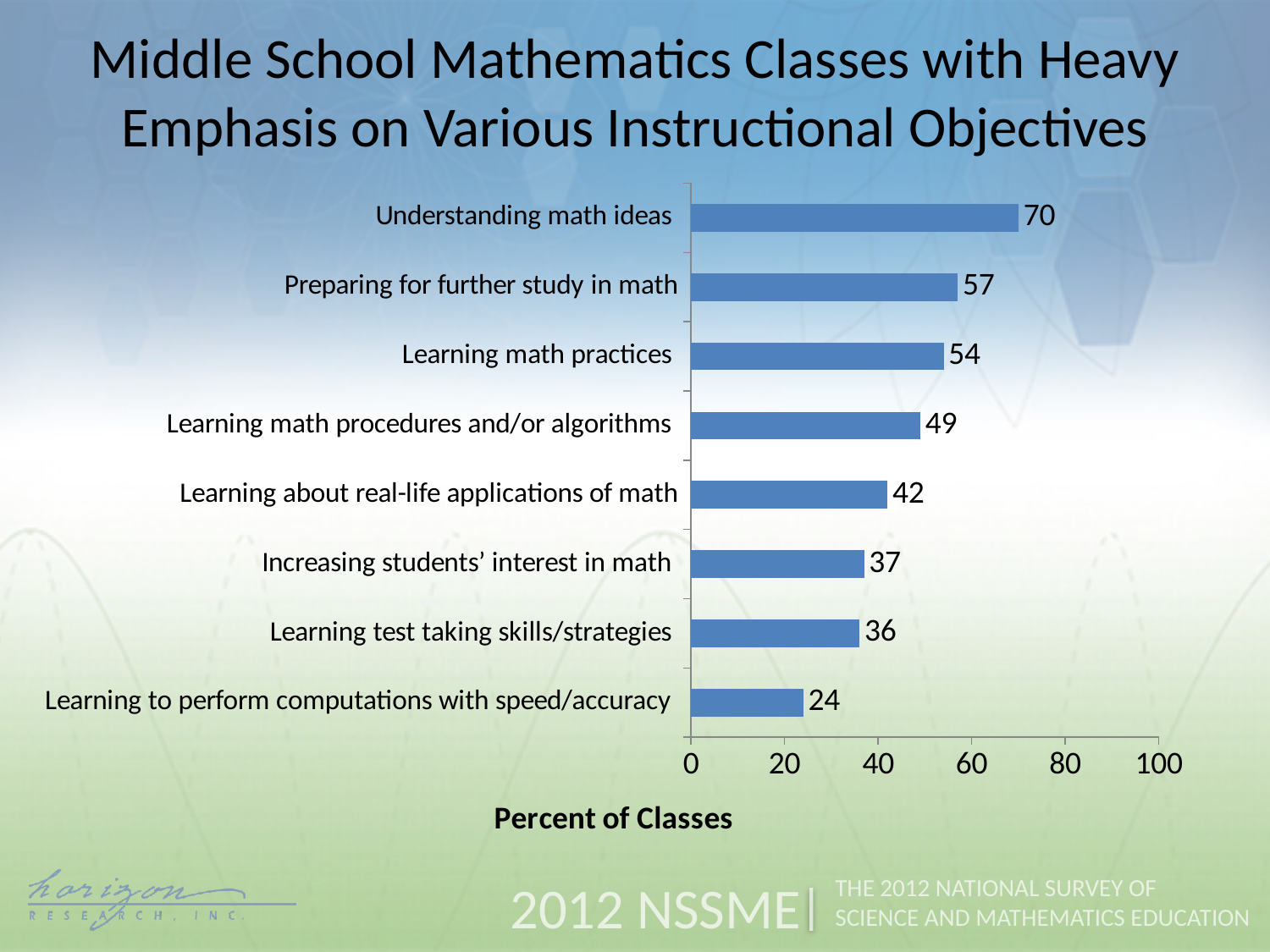
What percent of classes place heavy emphasis on understanding math ideas? 70 How many instructional objectives are shown in the chart? 8 Is the value for learning math practices greater or less than 40? greater Which instructional objective has the lowest percent of classes? Learning to perform computations with speed/accuracy Which instructional objective has the highest percent of classes? Understanding math ideas What is the value for learning test taking skills/strategies? 36 What is the value for learning about real-life applications of math? 42 What kind of chart is shown on the slide? Bar chart What is the label of the horizontal axis? Percent of Classes What is the difference between the values for understanding math ideas and learning to perform computations with speed/accuracy? 46 Which is larger: the value for learning math procedures and/or algorithms or the value for increasing students' interest in math? Learning math procedures and/or algorithms What is the difference between the values for preparing for further study in math and learning math practices? 3